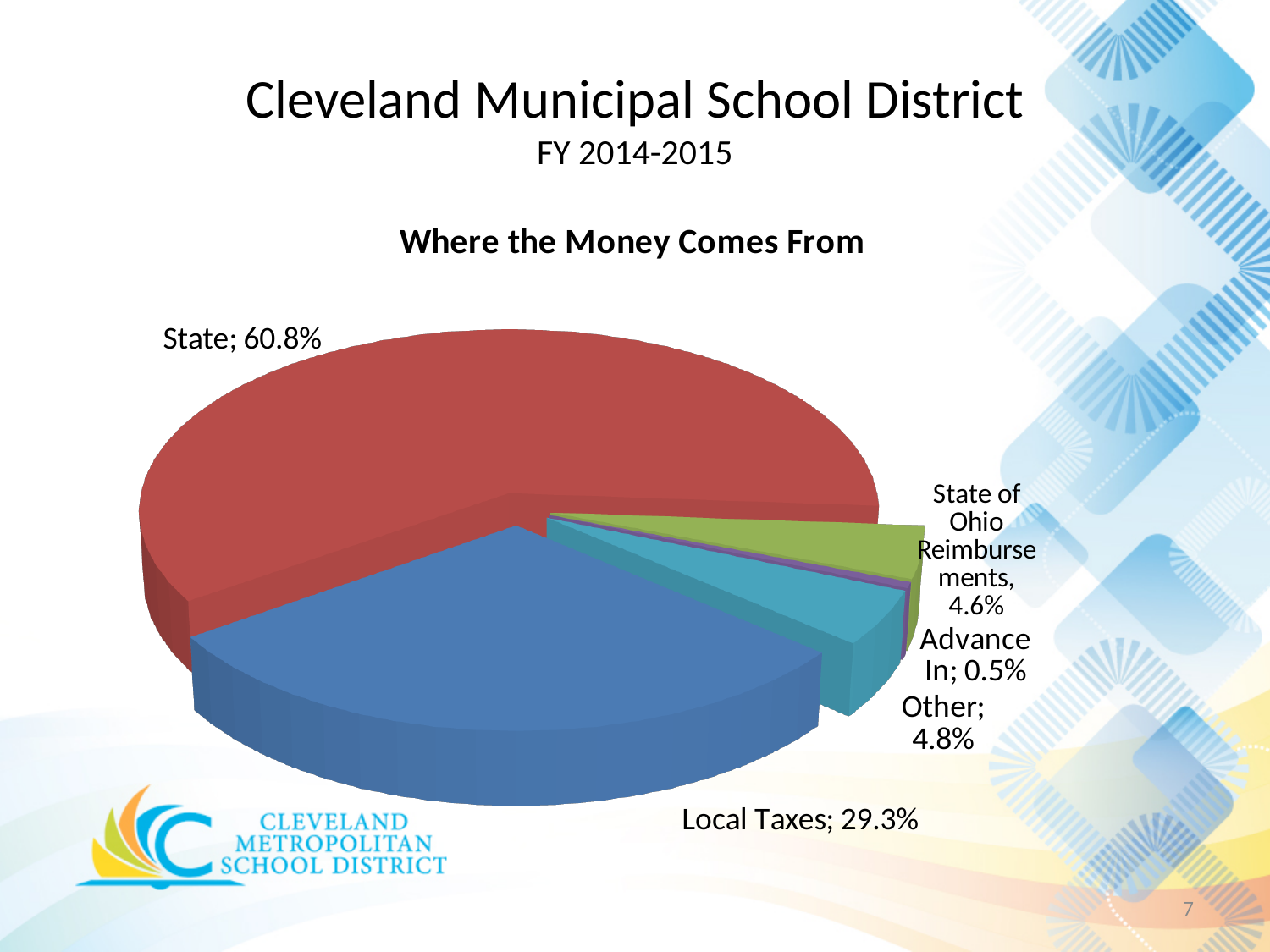
What share of the pie does Local Taxes account for? 29.3% How many slices does the pie chart have? 5 Which category has the largest share of the pie? State Which is larger, the share for Other or the share for State of Ohio Reimbursements? Other What share of the pie does State of Ohio Reimbursements account for? 4.6% Which category has the smallest share of the pie? Advance In What is the title of the chart? Where the Money Comes From What is the difference in percentage points between State and Local Taxes? 31.5 What share of the pie does State account for? 60.8% What share of the pie does Advance In account for? 0.5% What share of the pie does Other account for? 4.8% What kind of chart is shown on the slide? Pie chart